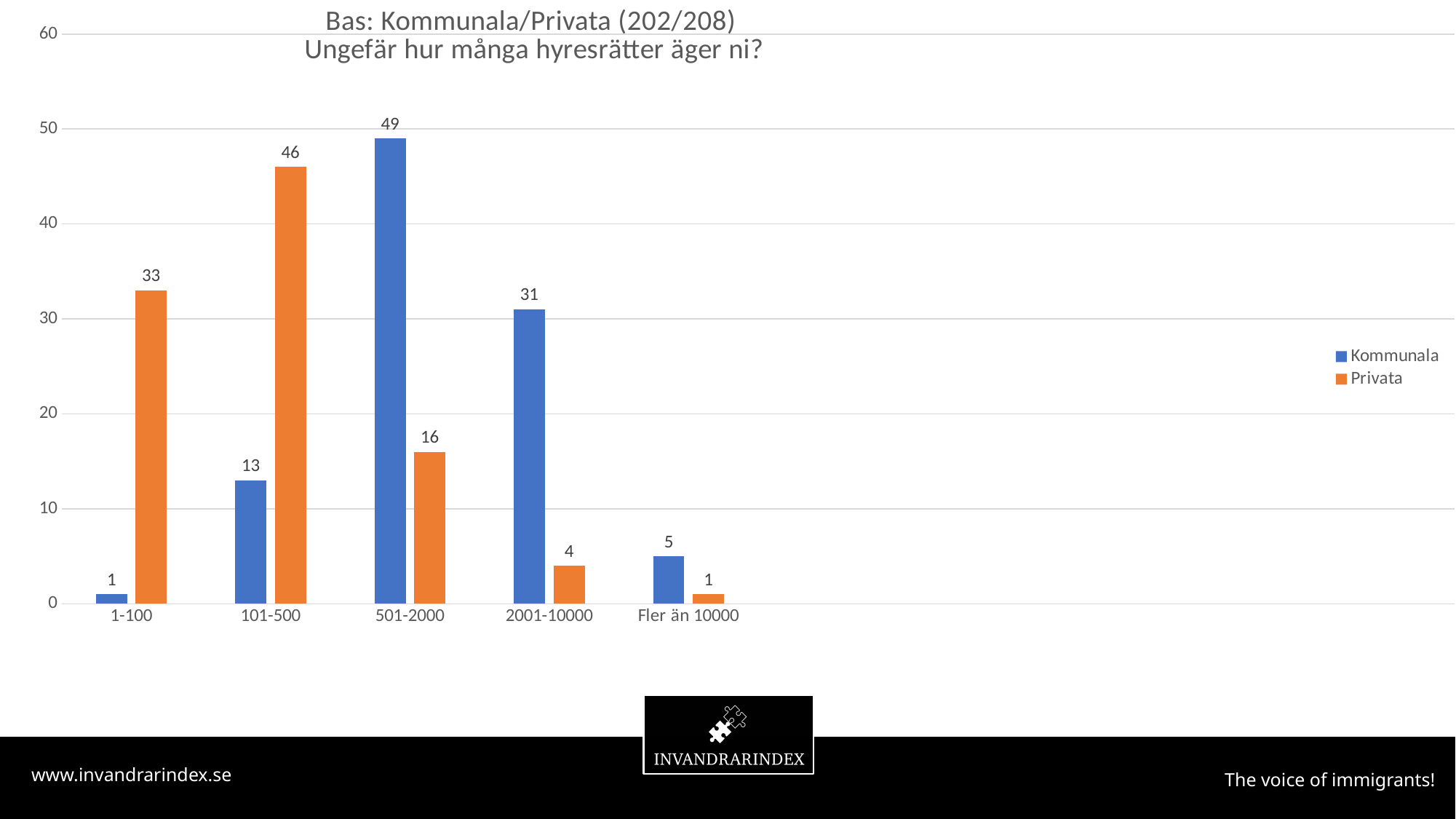
What is the value for Kommunala in the 501-2000 category? 49 How many series does the legend list? 2 What is the value for Privata in the 1-100 category? 33 Is the value for Kommunala in the 2001-10000 category greater or less than 20? greater What is the value for Privata in the 101-500 category? 46 Which category has the lowest value for Privata? Fler än 10000 How many categories are shown on the x axis? 5 What kind of chart is shown on the slide? bar chart What is the difference between Kommunala and Privata in the 2001-10000 category? 27 Which category has the highest value for Kommunala? 501-2000 Which colour represents the Privata series? orange Which is larger in the 101-500 category, Kommunala or Privata? Privata